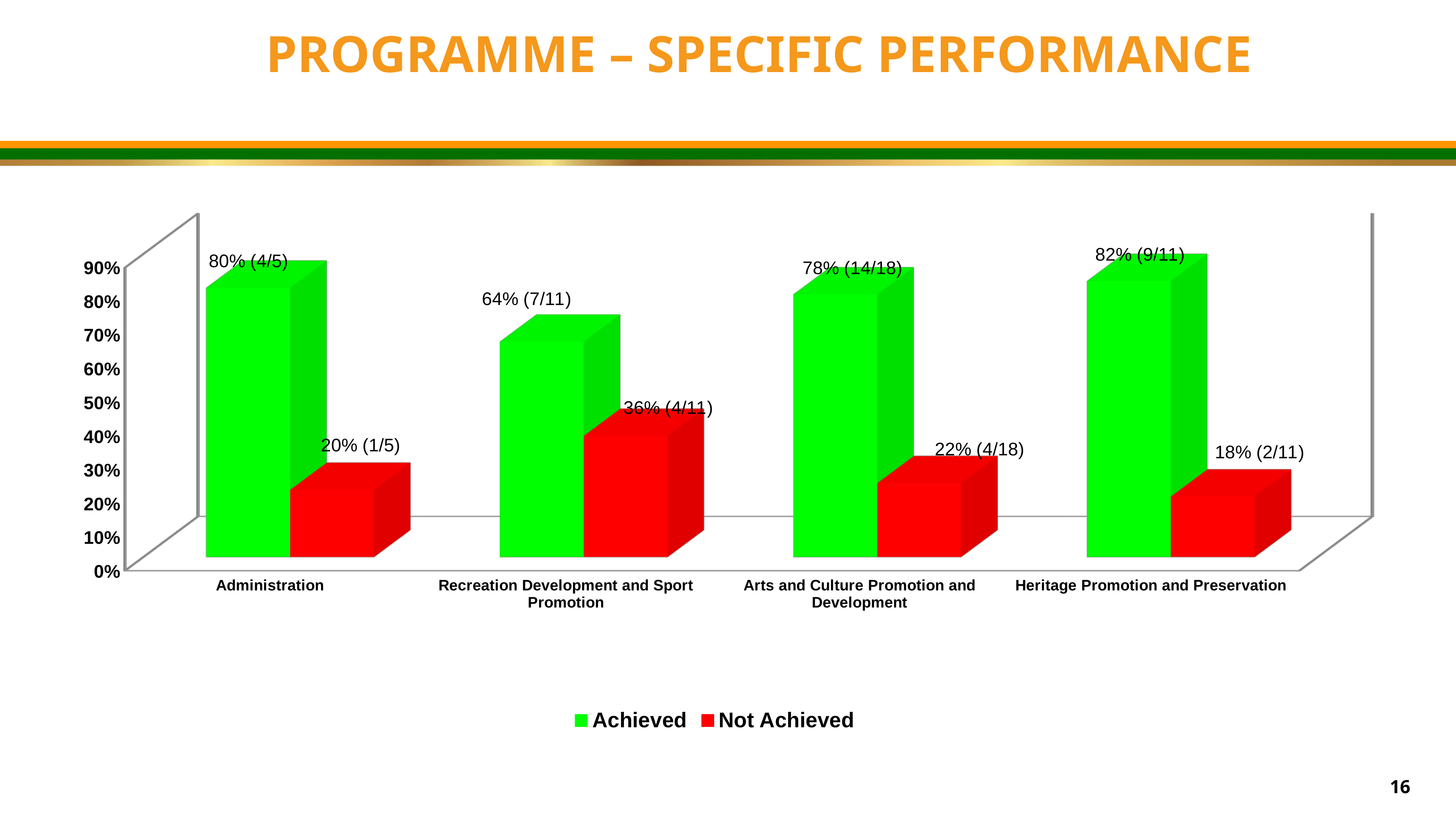
How many programmes are shown on the x axis? 4 What is the Not Achieved value for Recreation Development and Sport Promotion? 36% (4/11) What is the difference in percentage points between the Achieved and Not Achieved values for Administration? 60 percentage points How many series does the legend list? 2 Which programme has the highest Not Achieved percentage? Recreation Development and Sport Promotion What type of chart is shown on the slide? Bar chart What is the Achieved value for Administration? 80% (4/5) Is the Achieved percentage higher for Administration or for Arts and Culture Promotion and Development? Administration What is the Not Achieved value for Heritage Promotion and Preservation? 18% (2/11) Which programme has the highest Achieved percentage? Heritage Promotion and Preservation Which programme has the lowest Achieved percentage? Recreation Development and Sport Promotion What is the Achieved value for Arts and Culture Promotion and Development? 78% (14/18)